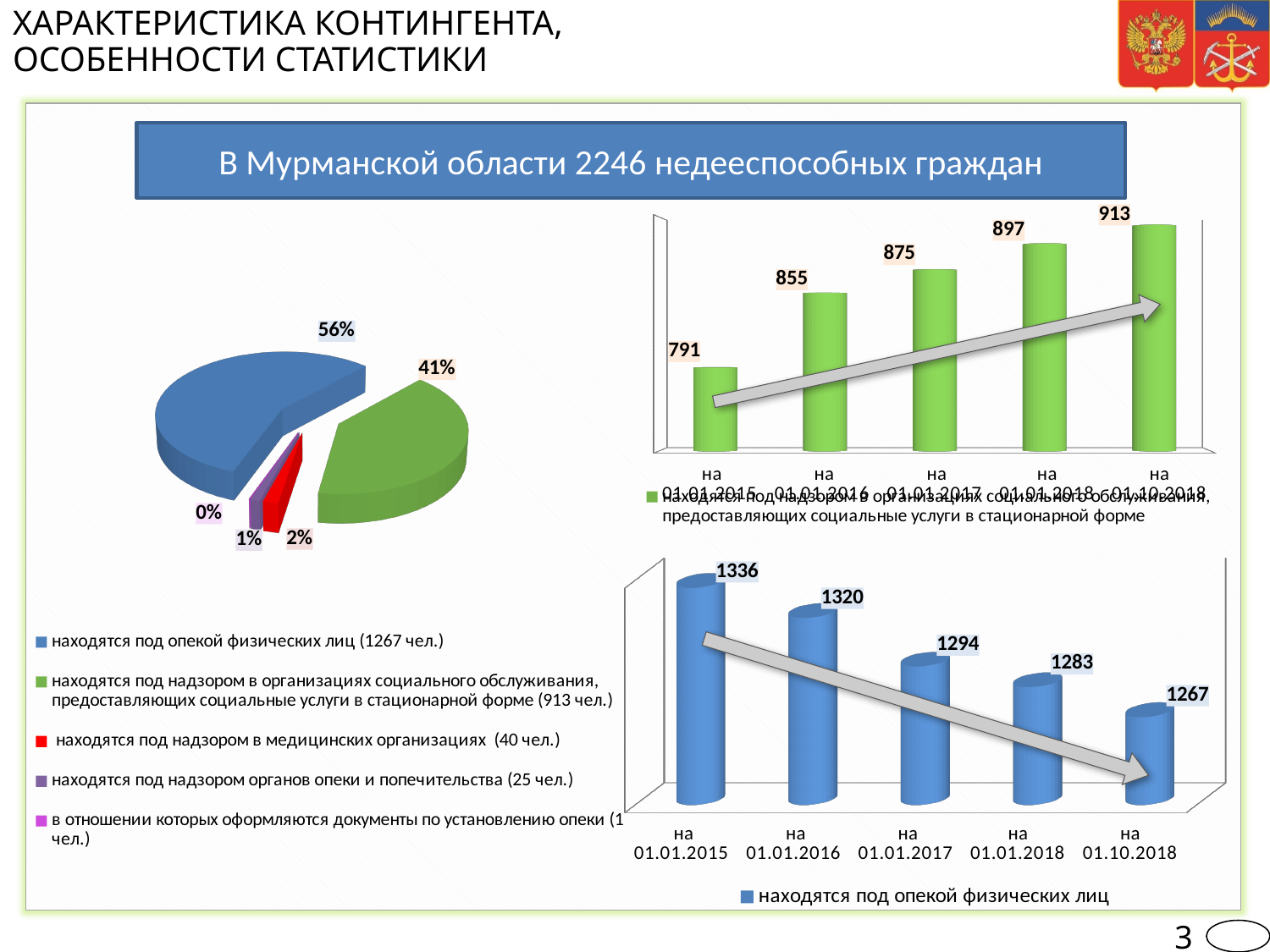
In the top-right bar chart, do the values rise or fall from 01.01.2015 to 01.10.2018? rise In the bottom-right bar chart, what is the value for 01.01.2017? 1294 What type of chart is shown on the left of the slide? pie chart How many bars are in the bottom-right bar chart? 5 In the bottom-right bar chart, do the values rise or fall from 01.01.2015 to 01.10.2018? fall In the top-right bar chart, which date has the lowest value? 01.01.2015 In the bottom-right bar chart, which date has the highest value? 01.01.2015 In the top-right bar chart, what is the difference between the values for 01.10.2018 and 01.01.2015? 122 In the bottom-right bar chart, what is the difference between the values for 01.01.2015 and 01.10.2018? 69 In the top-right bar chart, what is the value for 01.10.2018? 913 In the pie chart on the left, what share is shown for the blue slice (находятся под опекой физических лиц)? 56% In the top-right bar chart, what is the value for 01.01.2015? 791